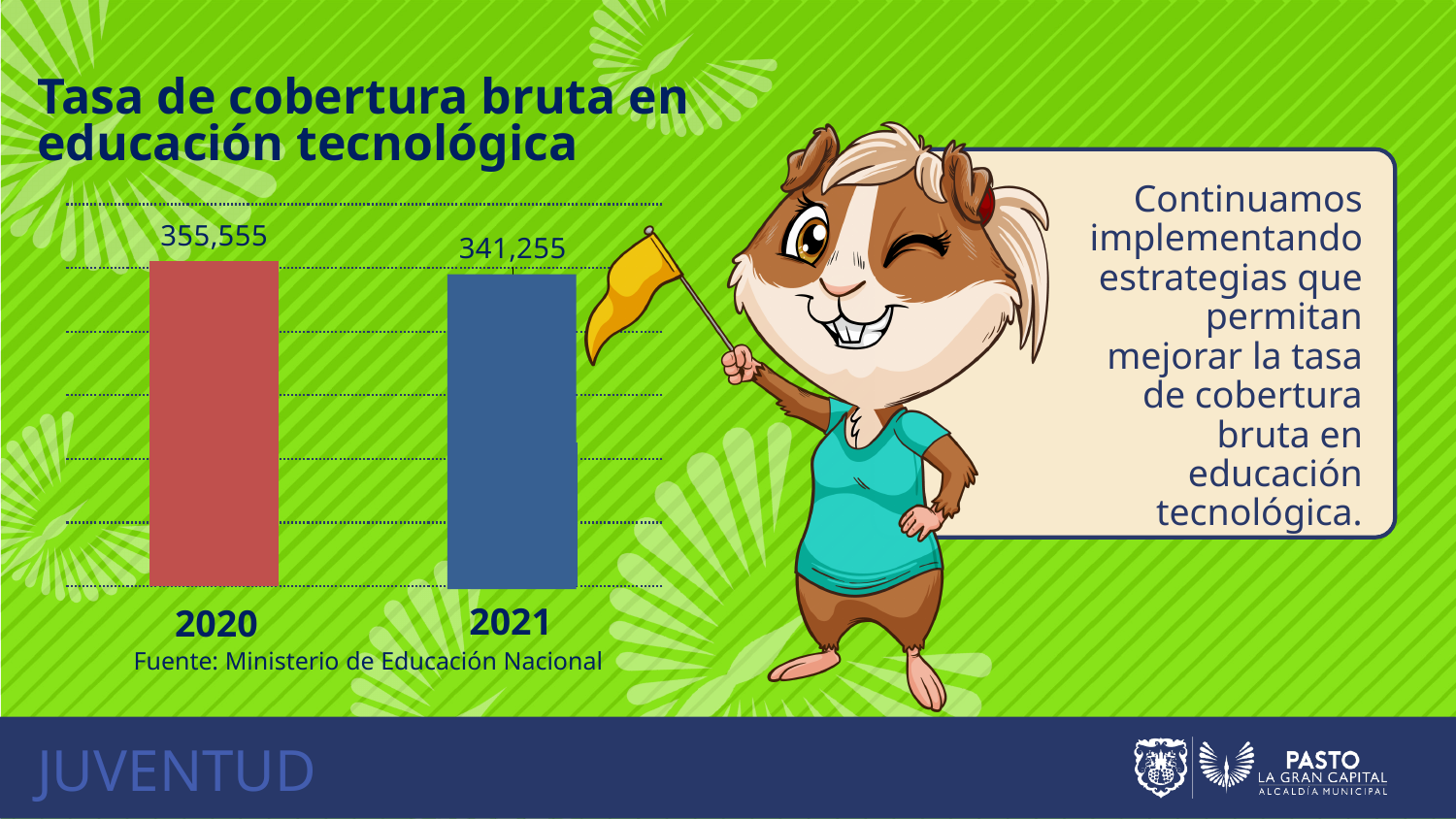
What is the value for 2020? 355,555 What is the difference between the 2020 and 2021 values? 14,300 What colour is the bar for 2020? red Which year has the higher value? 2020 Do the values rise or fall from 2020 to 2021? fall What kind of chart is shown on the slide? bar chart How many years are shown in the chart? 2 What is the title of the chart? Tasa de cobertura bruta en educación tecnológica What is the value for 2021? 341,255 Which year has the lower value? 2021 Is the value for 2021 larger or smaller than the value for 2020? smaller